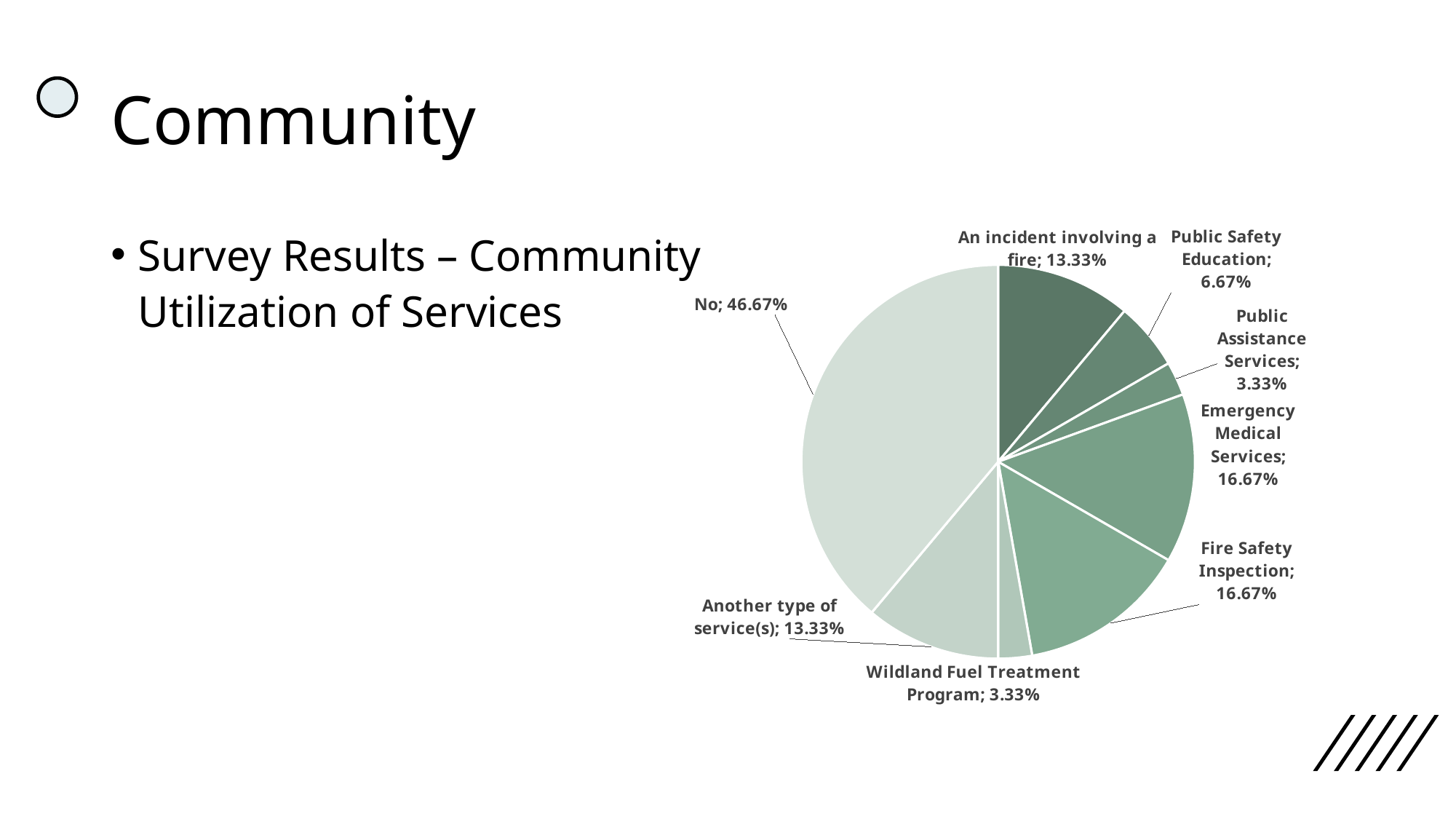
What is the value for Emergency Medical Services? 16.67% What percentage of the pie is labelled "No"? 46.67% Which is larger, An incident involving a fire or Public Safety Education? An incident involving a fire What is the difference between Fire Safety Inspection and Public Assistance Services? 13.34% What is the difference between the No slice and the Emergency Medical Services slice? 30.00% What is the value for Wildland Fuel Treatment Program? 3.33% What is the value for An incident involving a fire? 13.33% How many slices does the pie chart have? 8 What kind of chart is shown on the slide? Pie chart Which slice of the pie is the largest? No What share of the pie does Another type of service(s) represent? 13.33% What is the value for Public Safety Education? 6.67%